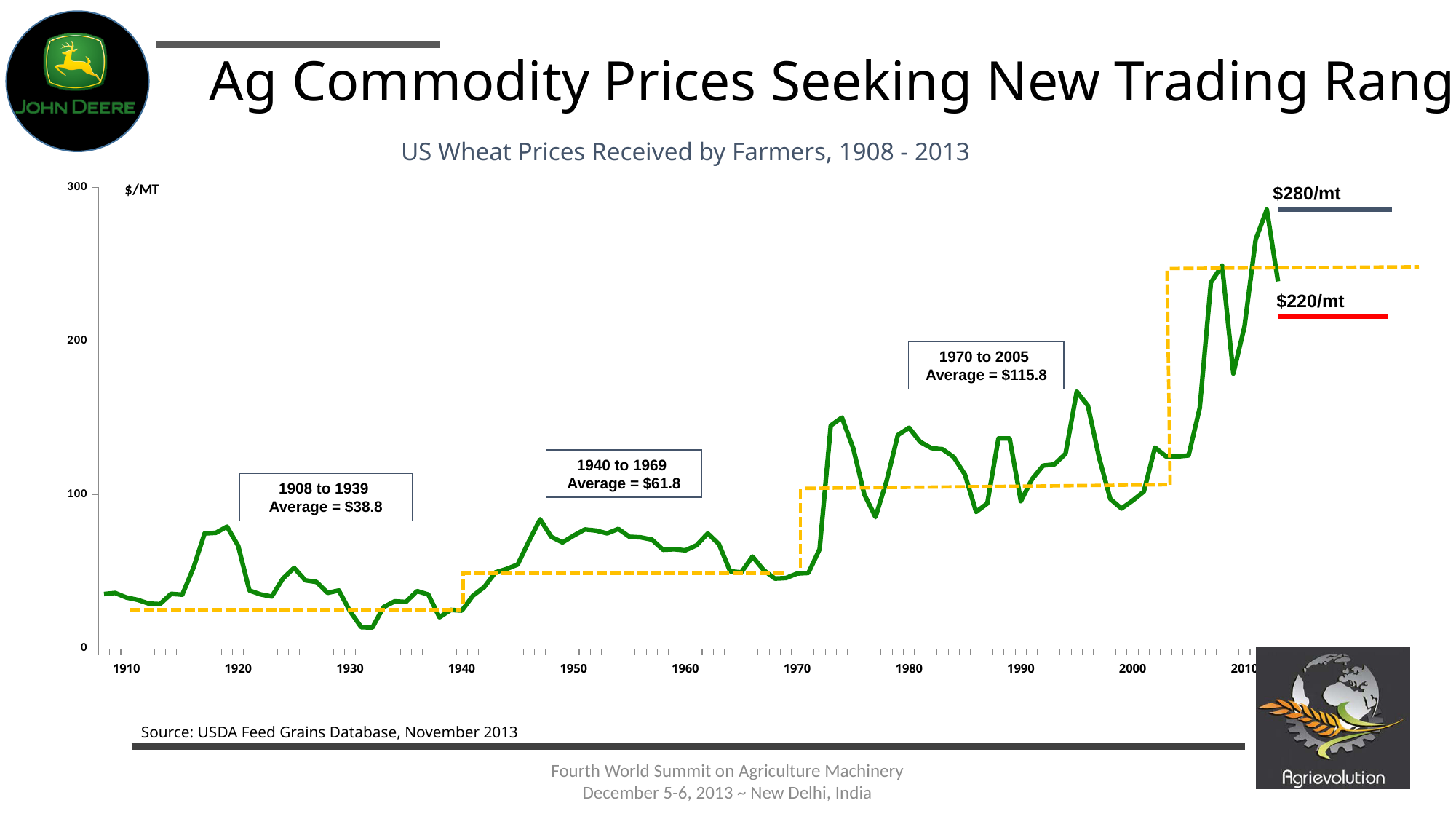
What unit is shown on the vertical axis of the chart? $/MT What is the average US wheat price shown for the period 1940 to 1969? $61.8 Overall, do US wheat prices rise or fall from 1910 to 2010? rise How much higher is the 1970 to 2005 average than the 1940 to 1969 average? $54.0 Which period has the higher average price, 1908 to 1939 or 1940 to 1969? 1940 to 1969 How much higher is the 1940 to 1969 average than the 1908 to 1939 average? $23.0 What kind of chart is shown on the slide? line chart What is the average US wheat price shown for the period 1908 to 1939? $38.8 Is the wheat price in 1974 greater or less than 100 $/MT? greater Is the peak wheat price reached after 2010 greater or less than 200 $/MT? greater Is the wheat price in 1932 greater or less than 100 $/MT? less What is the average US wheat price shown for the period 1970 to 2005? $115.8